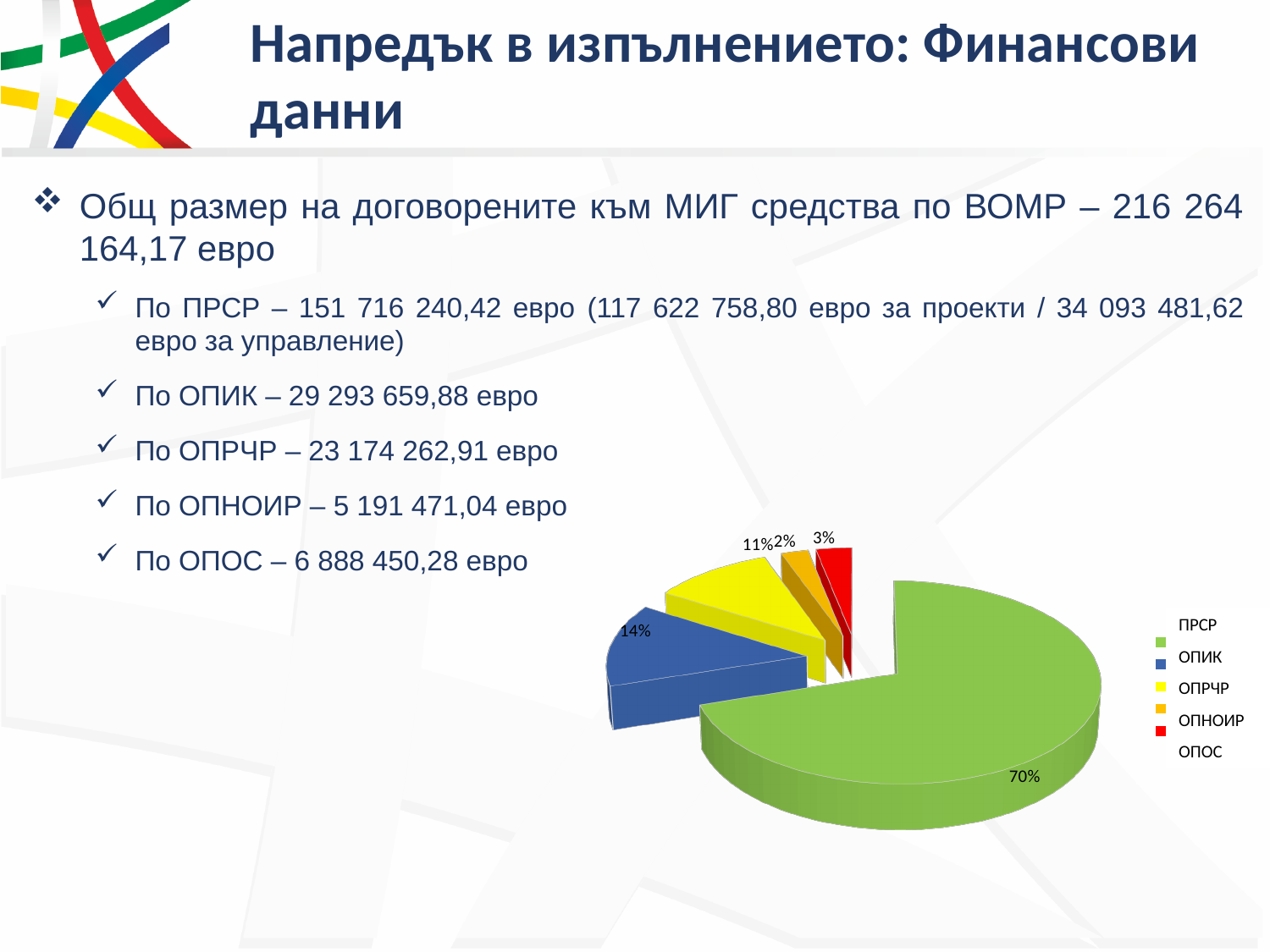
Which category has the largest slice of the pie? ПРСР What is the value shown for ОПРЧР in the pie chart? 11% What kind of chart is shown on the slide? pie chart What share of the pie does ПРСР represent? 70% What is the value shown for ОПОС in the pie chart? 3% Which colour represents ОПОС in the pie chart? red What is the value shown for ОПИК in the pie chart? 14% What is the value shown for ОПНОИР in the pie chart? 2% Which category has the smallest slice of the pie? ОПНОИР How many slices does the pie chart have? 5 How many entries does the legend list? 5 What is the difference in percentage points between the ОПИК and ОПРЧР slices? 3%